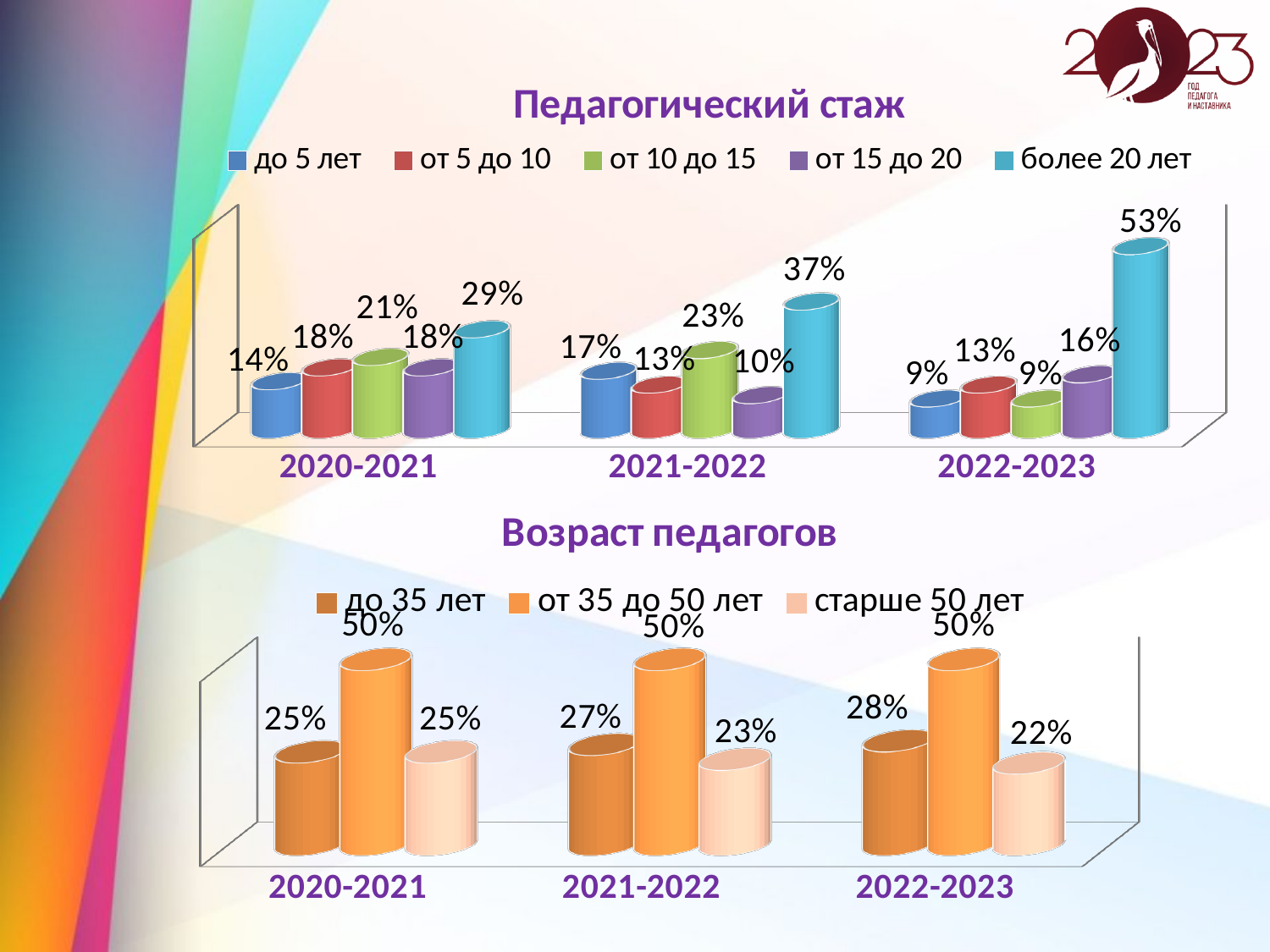
What kind of chart is the chart titled "Возраст педагогов"? Bar chart In the chart titled "Педагогический стаж", which series has the highest value in 2020-2021? более 20 лет In the chart titled "Педагогический стаж", how does the value for "более 20 лет" change from 2020-2021 to 2022-2023? It rises In the chart titled "Педагогический стаж", what is the value for "более 20 лет" in 2022-2023? 53% How many categories are shown on the x axis of the chart titled "Возраст педагогов"? 3 In the chart titled "Возраст педагогов", which is larger in 2022-2023: "до 35 лет" or "старше 50 лет"? до 35 лет In the chart titled "Возраст педагогов", what is the value for "до 35 лет" in 2022-2023? 28% In the chart titled "Педагогический стаж", what is the difference between the "более 20 лет" values for 2022-2023 and 2020-2021? 24% In the chart titled "Педагогический стаж", what is the value for "от 10 до 15" in 2021-2022? 23% How many series does the legend of the chart titled "Педагогический стаж" list? 5 In the chart titled "Педагогический стаж", which series has the lowest value in 2021-2022? от 15 до 20 In the chart titled "Возраст педагогов", what is the value for "старше 50 лет" in 2021-2022? 23%